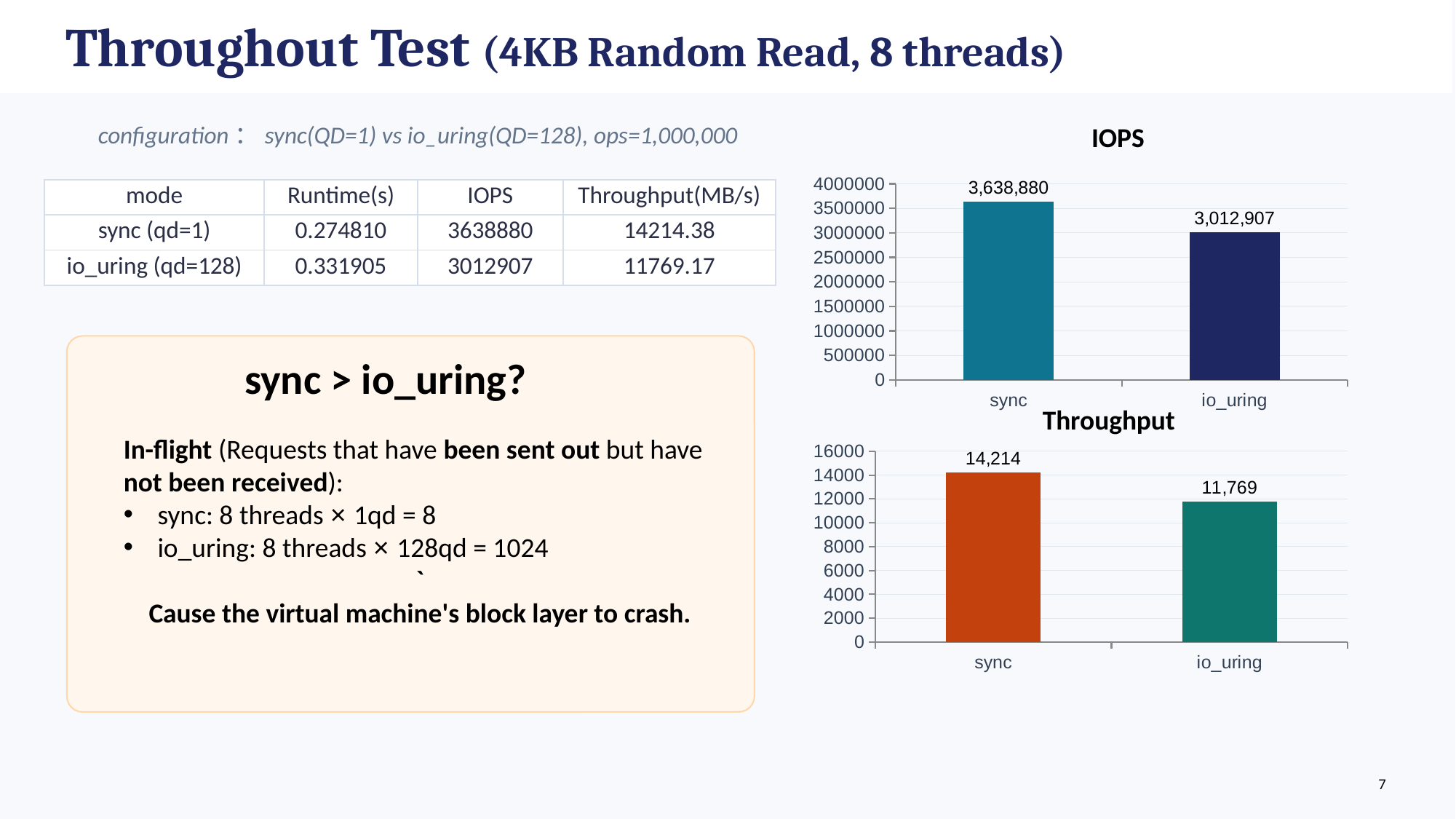
In the Throughput chart, what is the difference between the sync and io_uring values? 2,445 In the IOPS chart, what is the value for io_uring? 3,012,907 In the IOPS chart, what is the difference between the sync and io_uring values? 625,973 In the IOPS chart, how many categories are shown on the x axis? 2 What is the title of the upper chart on the slide? IOPS In the Throughput chart, what is the value for io_uring? 11,769 In the Throughput chart, what is the value for sync? 14,214 What kind of chart is the Throughput chart? bar chart In the Throughput chart, which category has the lowest value? io_uring In the IOPS chart, what is the value for sync? 3,638,880 In the IOPS chart, which category has the highest value? sync In the Throughput chart, is the value for io_uring greater or less than 12000? less